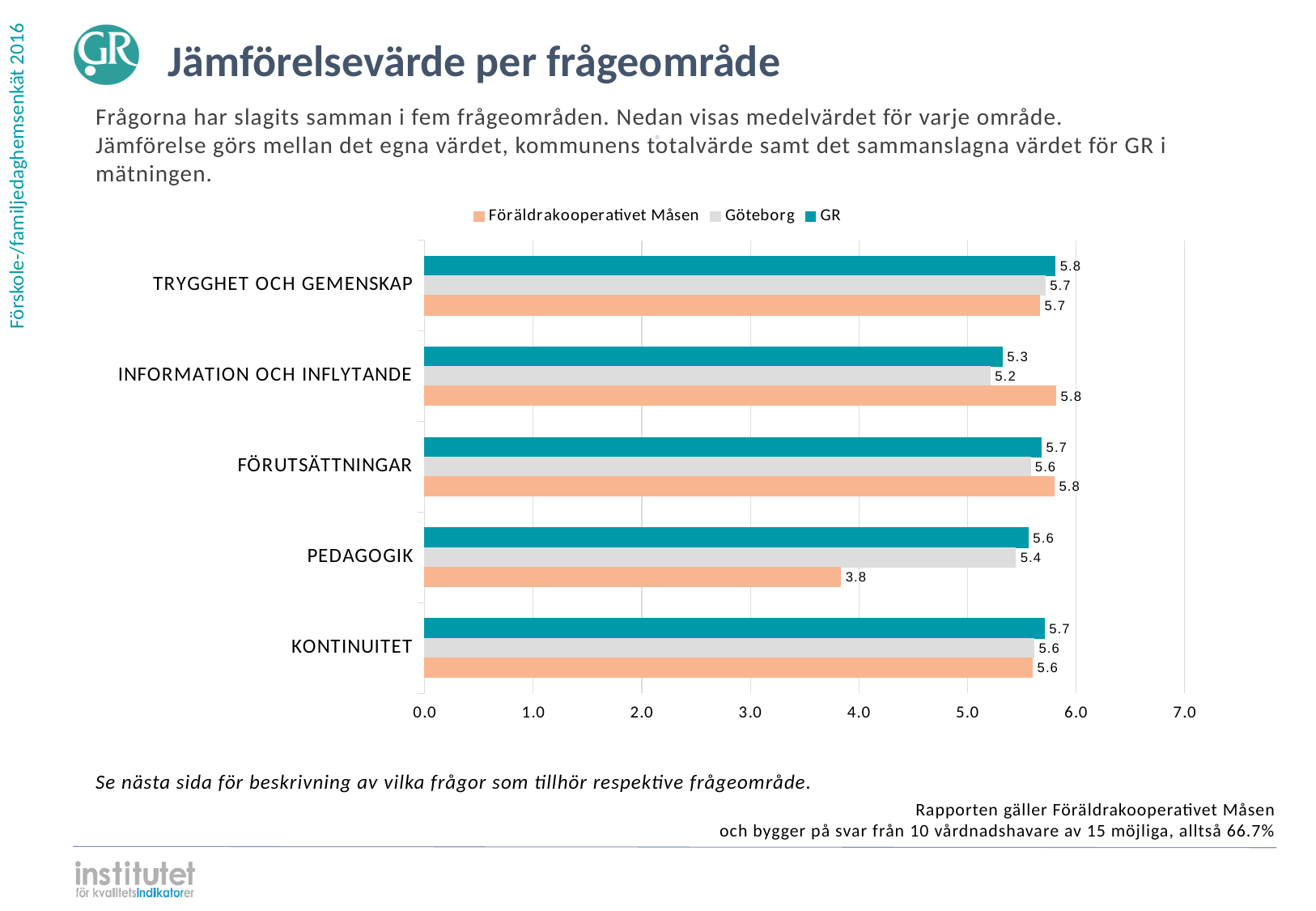
Which category has the lowest value for GR? INFORMATION OCH INFLYTANDE Which colour represents the GR series in the chart? Teal Is the value for Föräldrakooperativet Måsen in PEDAGOGIK greater or less than 4.0? less What is the value for Göteborg in INFORMATION OCH INFLYTANDE? 5.2 Which category has the lowest value for Föräldrakooperativet Måsen? PEDAGOGIK In INFORMATION OCH INFLYTANDE, which is larger: the value for Föräldrakooperativet Måsen or the value for Göteborg? Föräldrakooperativet Måsen What kind of chart is shown on the slide? Bar chart What is the difference between the GR value and the Föräldrakooperativet Måsen value in PEDAGOGIK? 1.8 How many question areas (categories) are shown on the chart? 5 How many series does the legend list? 3 What is the value for Föräldrakooperativet Måsen in PEDAGOGIK? 3.8 What is the value for GR in TRYGGHET OCH GEMENSKAP? 5.8